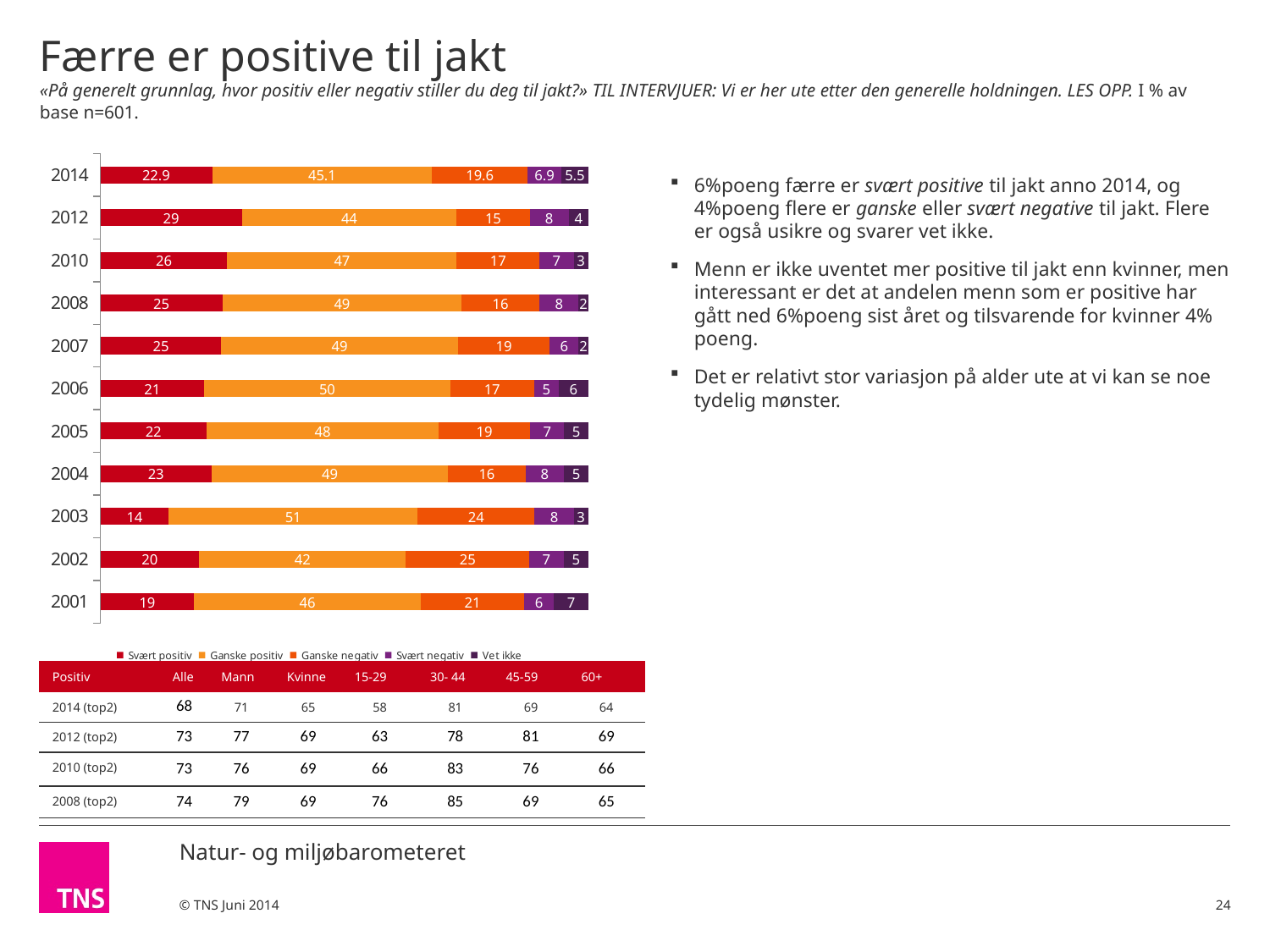
How many series does the legend list? 5 Which year has the larger Ganske negativ value, 2002 or 2003? 2002 How many years are shown in the chart? 11 What is the value for Svært positiv in 2014? 22.9 What kind of chart is shown on the slide? Stacked bar chart What is the difference between the Svært positiv values for 2012 and 2014? 6.1 What is the value for Ganske positiv in 2006? 50 Which series is shown in red in the chart? Svært positiv What is the total of the stacked bar for 2012? 100 In which year is the Svært positiv value lowest? 2003 What is the value for Vet ikke in 2001? 7 In which year is the Svært positiv value highest? 2012